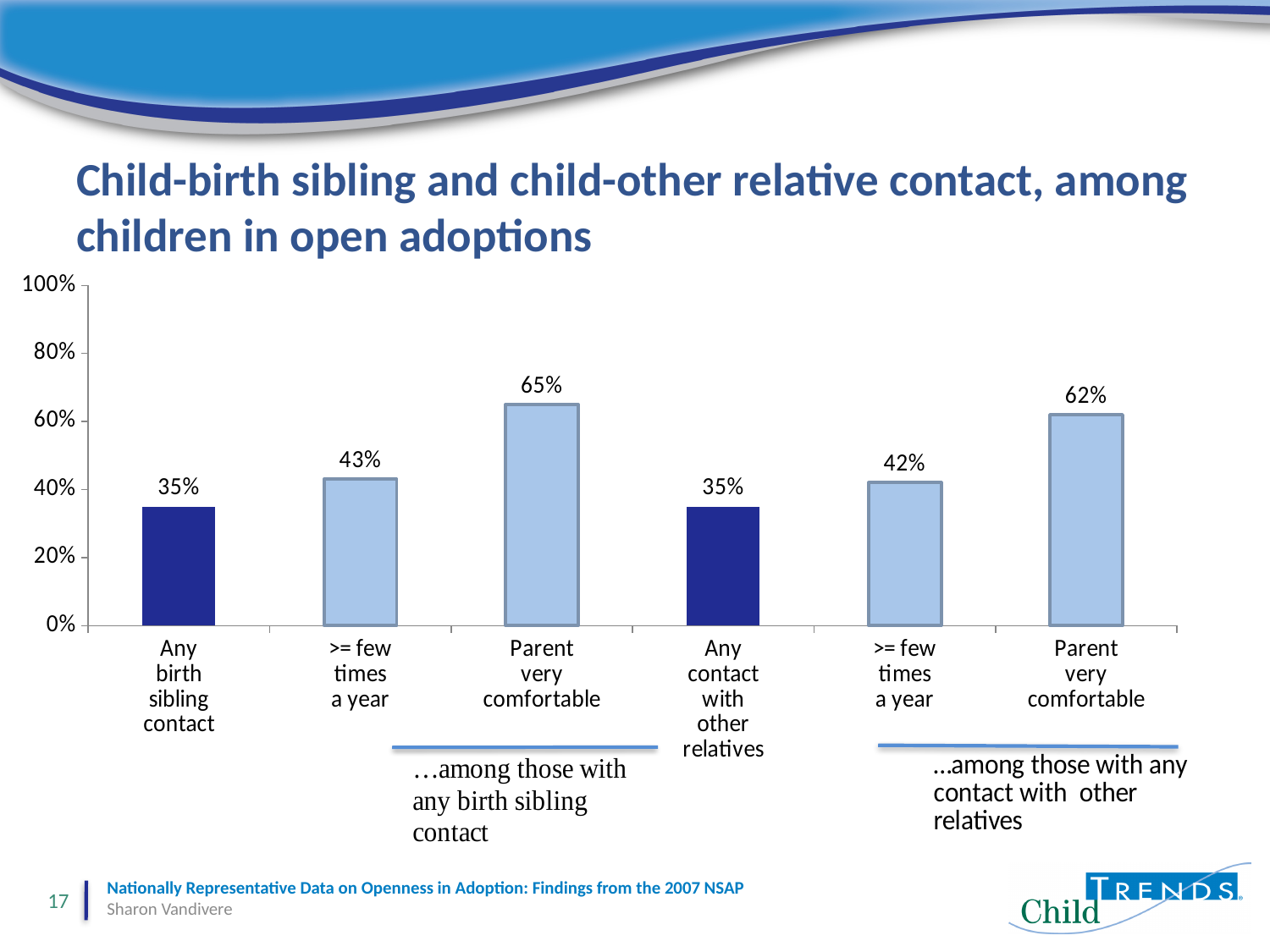
What is the value for "Any contact with other relatives"? 35% What is the value for ">= few times a year" among those with any contact with other relatives? 42% What kind of chart is shown on the slide? Bar chart What is the value for "Any birth sibling contact"? 35% What is the difference between ">= few times a year" among those with any birth sibling contact and "Any birth sibling contact"? 8% Is the value for "Parent very comfortable" among those with any contact with other relatives greater or less than 60%? greater What is the difference between "Parent very comfortable" among those with any birth sibling contact and "Parent very comfortable" among those with any contact with other relatives? 3% Which bar has the highest value? Parent very comfortable (among those with any birth sibling contact) What is the highest value shown on the vertical axis? 100% How many bars are shown in the chart? 6 What is the value for "Parent very comfortable" among those with any birth sibling contact? 65% Which is larger: ">= few times a year" among those with any birth sibling contact or ">= few times a year" among those with any contact with other relatives? >= few times a year among those with any birth sibling contact